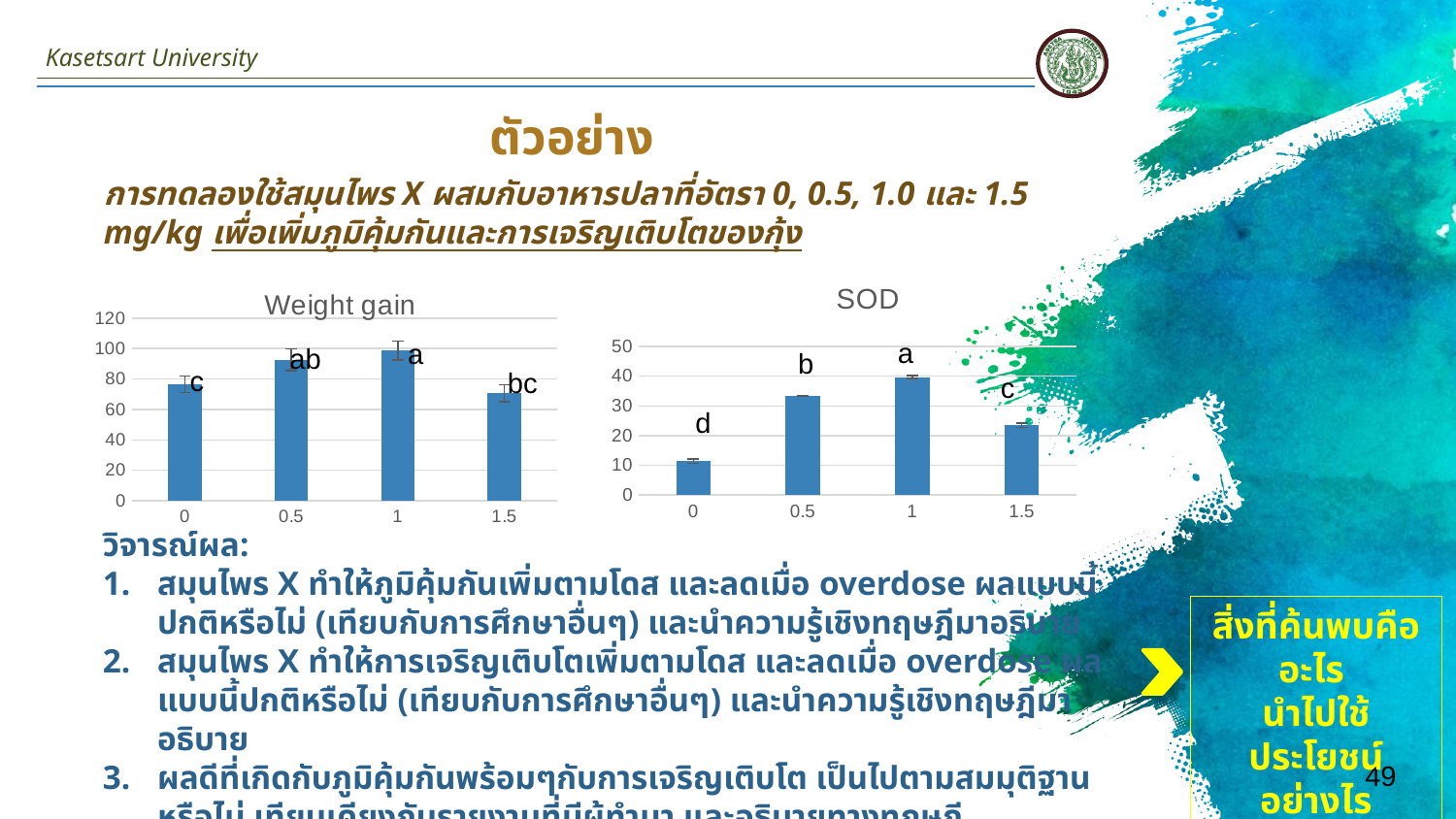
In the Weight gain chart, is the value for 0 greater or less than 60? greater In the SOD chart, which category has the lowest bar? 0 In the SOD chart, which category has the highest bar? 1 How many categories are shown on the x axis of the SOD chart? 4 In the SOD chart, which is larger, the bar for 0.5 or the bar for 1.5? 0.5 In the SOD chart, is the value for 0 greater or less than 20? less In the Weight gain chart, which is larger, the bar for 0.5 or the bar for 1.5? 0.5 In the SOD chart, what letter is printed above the bar for category 0? d In the SOD chart, is the value for 1 greater or less than 30? greater What kind of chart is the Weight gain chart? bar chart In the SOD chart, do the values rise or fall from category 0 to category 1? rise